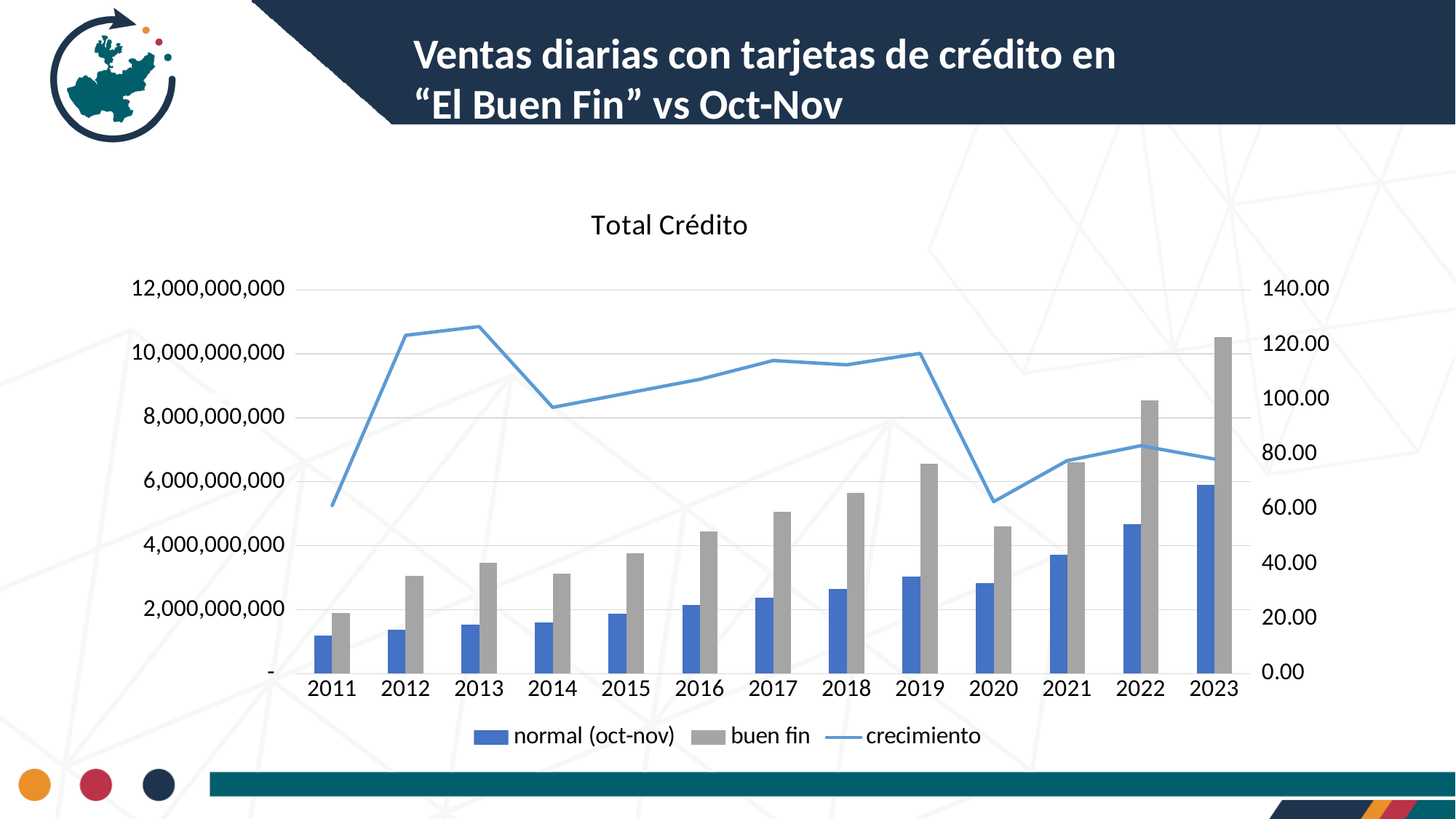
In which year is the buen fin bar the highest? 2023 How many series does the legend list? 3 Do the normal (oct-nov) bars generally rise or fall from 2011 to 2023? rise Is the crecimiento value for 2020 greater or less than 80.00? less Is the buen fin value for 2023 greater or less than 10,000,000,000? greater Is the crecimiento value for 2013 greater or less than 120.00? greater In which year is the buen fin bar the lowest? 2011 How many years are shown on the x axis? 13 What is the title of the chart? Total Crédito What kind of chart is this? Combined bar and line chart Which is larger, the buen fin bar for 2019 or for 2020? 2019